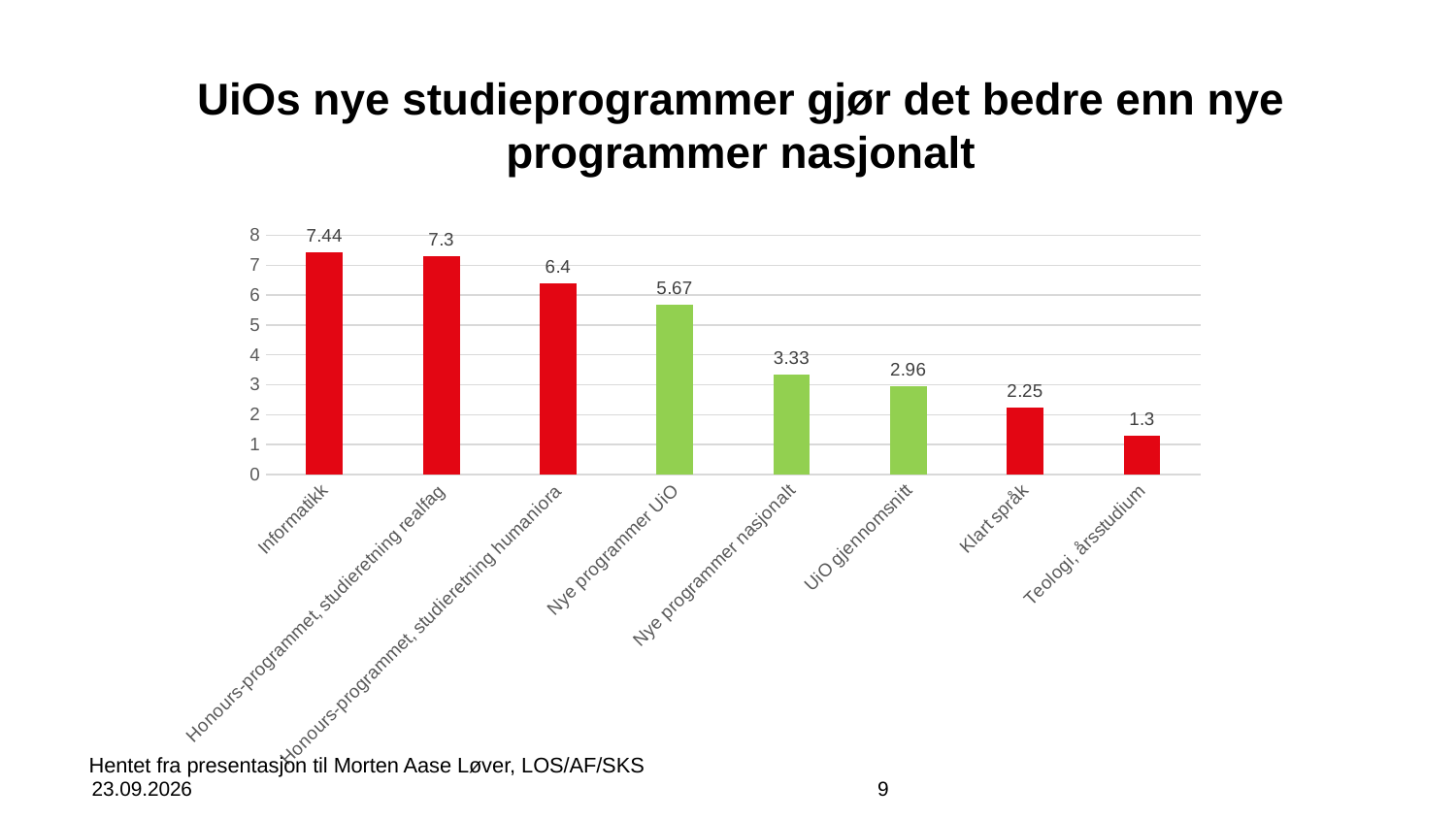
How many categories are shown in the chart? 8 What kind of chart is shown on the slide? Bar chart Which category has the lowest value? Teologi, årsstudium Which category has the highest value? Informatikk What is the value for Nye programmer UiO? 5.67 What colour are the bars for Nye programmer UiO, Nye programmer nasjonalt and UiO gjennomsnitt? Green What is the value for UiO gjennomsnitt? 2.96 What is the value for Informatikk? 7.44 What is the difference between Nye programmer UiO and Nye programmer nasjonalt? 2.34 What is the value for Nye programmer nasjonalt? 3.33 Which is larger, Klart språk or Teologi, årsstudium? Klart språk Do the values rise or fall from left to right along the x axis? Fall